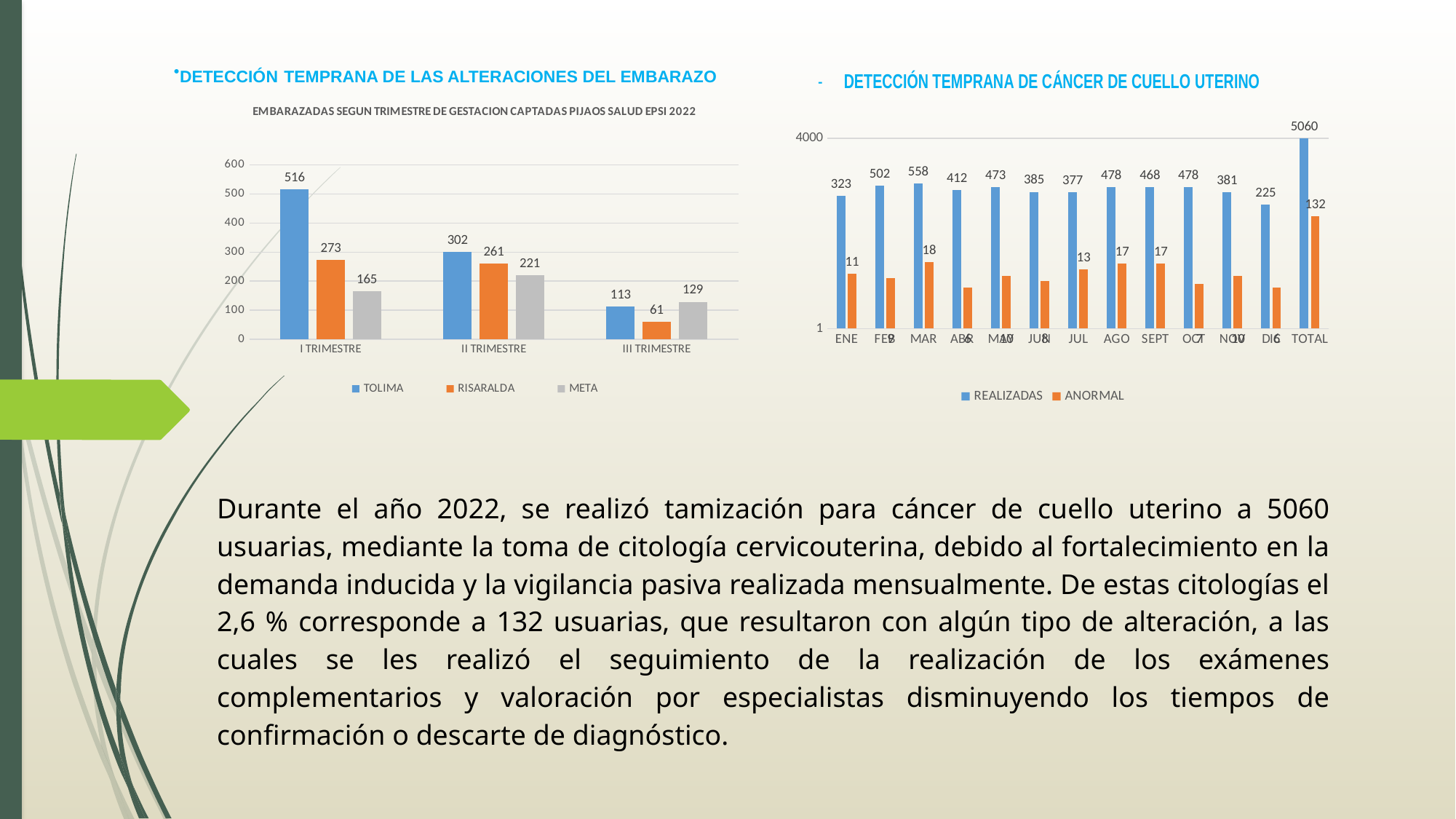
In the right chart (DETECCIÓN TEMPRANA DE CÁNCER DE CUELLO UTERINO), what is the difference between the REALIZADAS values for FEB and ENE? 179 In the left chart (EMBARAZADAS SEGUN TRIMESTRE DE GESTACION), how many series does the legend list? 3 In the left chart (EMBARAZADAS SEGUN TRIMESTRE DE GESTACION), does the TOLIMA value rise or fall from I TRIMESTRE to III TRIMESTRE? fall What kind of chart is the right chart (DETECCIÓN TEMPRANA DE CÁNCER DE CUELLO UTERINO)? bar chart In the right chart (DETECCIÓN TEMPRANA DE CÁNCER DE CUELLO UTERINO), what is the ANORMAL value for TOTAL? 132 In the right chart (DETECCIÓN TEMPRANA DE CÁNCER DE CUELLO UTERINO), which month has the lowest REALIZADAS value? DIC In the left chart (EMBARAZADAS SEGUN TRIMESTRE DE GESTACION), what is the value for TOLIMA in I TRIMESTRE? 516 In the left chart (EMBARAZADAS SEGUN TRIMESTRE DE GESTACION), which series has the highest value in II TRIMESTRE? TOLIMA In the left chart (EMBARAZADAS SEGUN TRIMESTRE DE GESTACION), which is larger in III TRIMESTRE, TOLIMA or META? META In the left chart (EMBARAZADAS SEGUN TRIMESTRE DE GESTACION), what is the difference between TOLIMA and META in I TRIMESTRE? 351 In the left chart (EMBARAZADAS SEGUN TRIMESTRE DE GESTACION), what is the value for RISARALDA in III TRIMESTRE? 61 In the right chart (DETECCIÓN TEMPRANA DE CÁNCER DE CUELLO UTERINO), what is the REALIZADAS value for MAR? 558